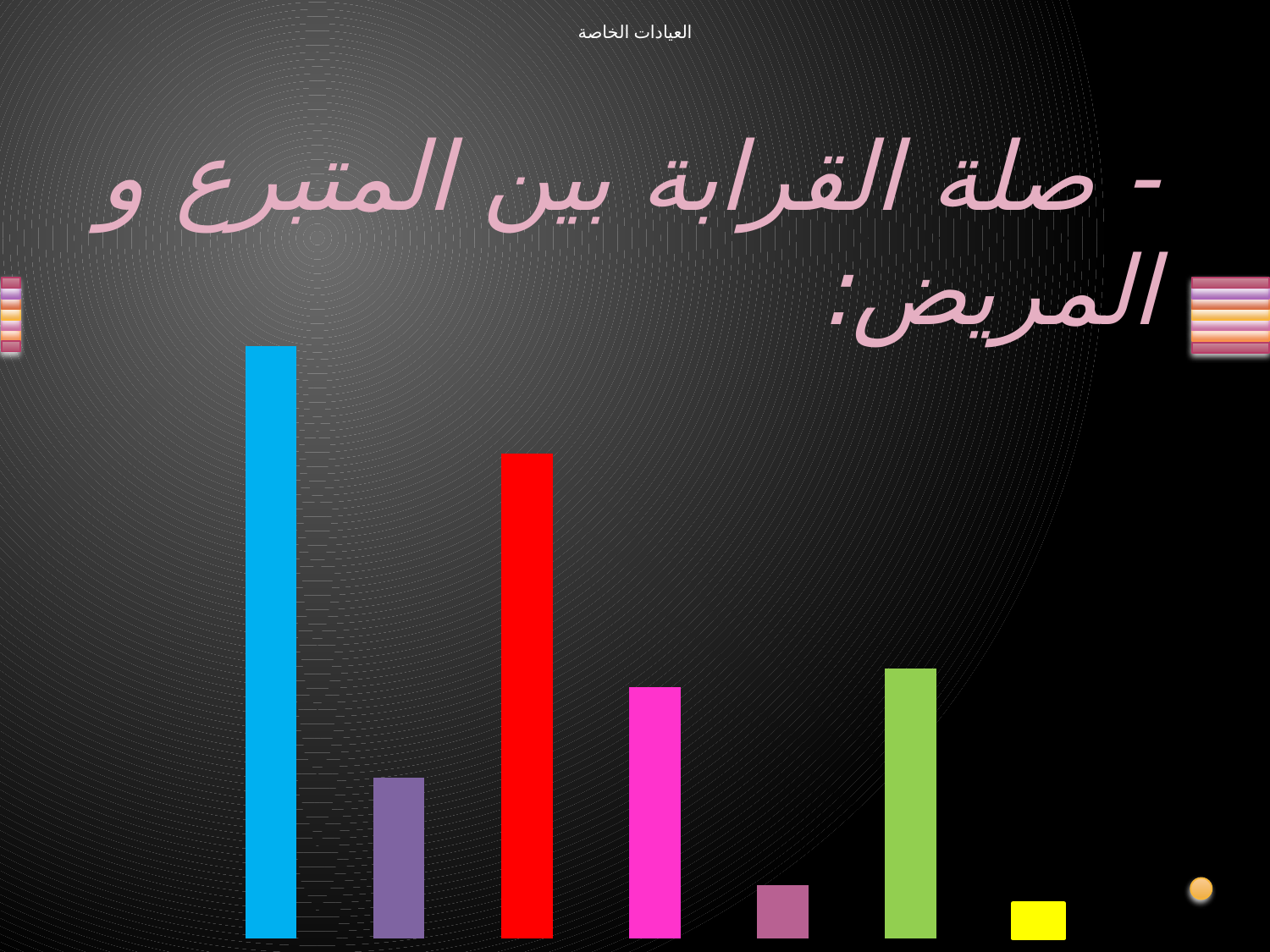
Which is taller, the magenta-pink bar (fourth from left) or the green bar? the green bar Does the chart display a legend? No Which is taller, the red bar or the pink bar? the red bar What is the title written above the chart? - صلة القرابة بين المتبرع و المريض: Which bar is the tallest in the chart? the blue bar (first from the left) Which bar is the second tallest in the chart? the red bar Which bar is the shortest in the chart? the yellow bar (last on the right) Which is taller, the purple bar or the green bar? the green bar What kind of chart is shown on the slide? bar chart How many bars does the chart contain? 7